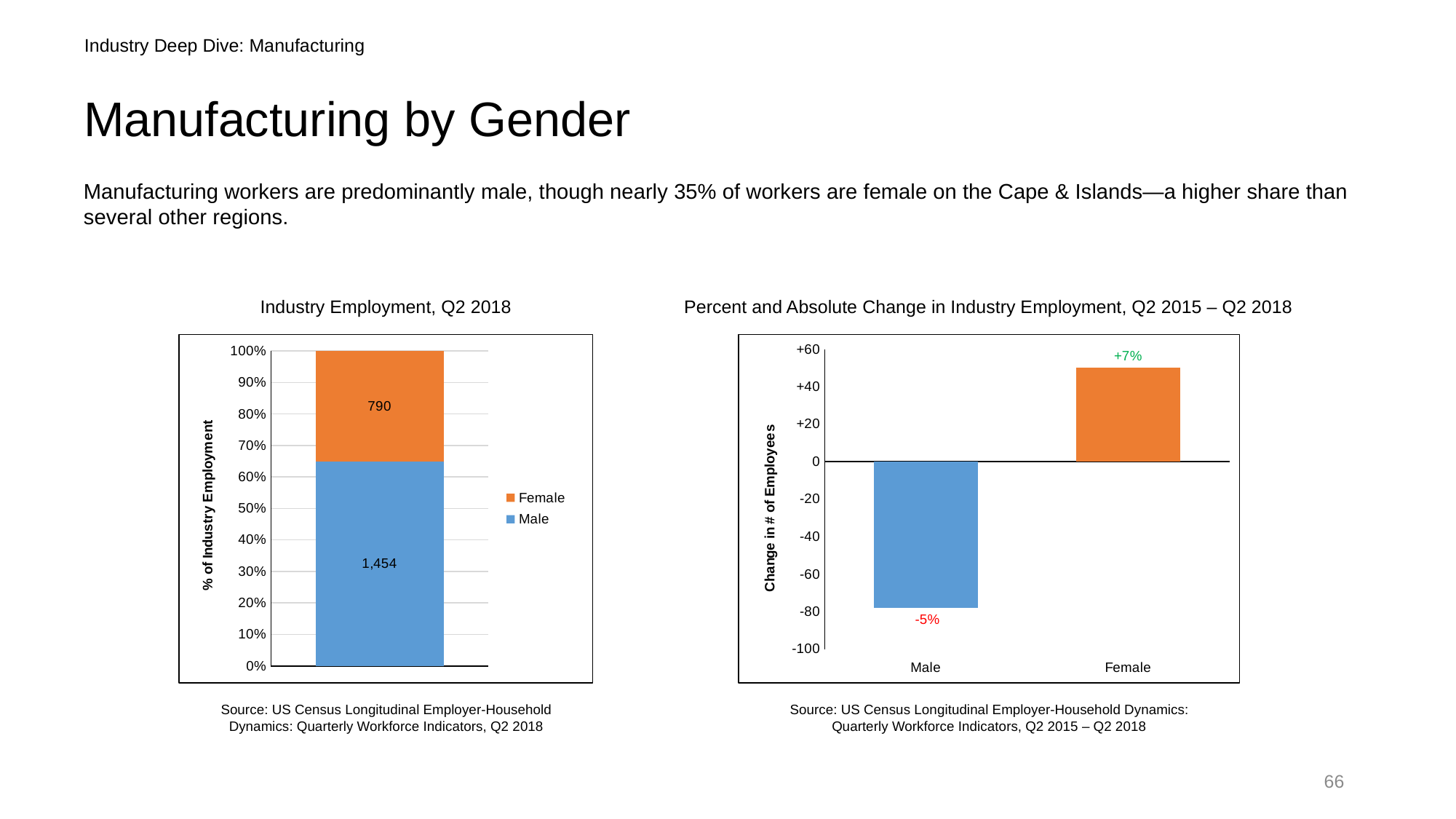
In the 'Percent and Absolute Change in Industry Employment, Q2 2015 – Q2 2018' chart, is the change in number of employees for Female greater or less than +40? greater In the 'Industry Employment, Q2 2018' chart, what is the value shown for Female? 790 What kind of chart is the 'Percent and Absolute Change in Industry Employment, Q2 2015 – Q2 2018' chart? Bar chart In the 'Industry Employment, Q2 2018' chart, what is the value shown for Male? 1,454 In the 'Industry Employment, Q2 2018' chart, which series has the larger value, Male or Female? Male In the 'Industry Employment, Q2 2018' chart, how many series does the legend list? 2 In the 'Percent and Absolute Change in Industry Employment, Q2 2015 – Q2 2018' chart, what percent change is labeled for Female? +7% In the 'Percent and Absolute Change in Industry Employment, Q2 2015 – Q2 2018' chart, which category shows a positive change in number of employees? Female In the 'Percent and Absolute Change in Industry Employment, Q2 2015 – Q2 2018' chart, what percent change is labeled for Male? -5% In the 'Industry Employment, Q2 2018' chart, what is the difference between the Male and Female values? 664 In the 'Percent and Absolute Change in Industry Employment, Q2 2015 – Q2 2018' chart, is the change in number of employees for Male greater or less than -60? less In the 'Industry Employment, Q2 2018' chart, what is the y-axis title? % of Industry Employment